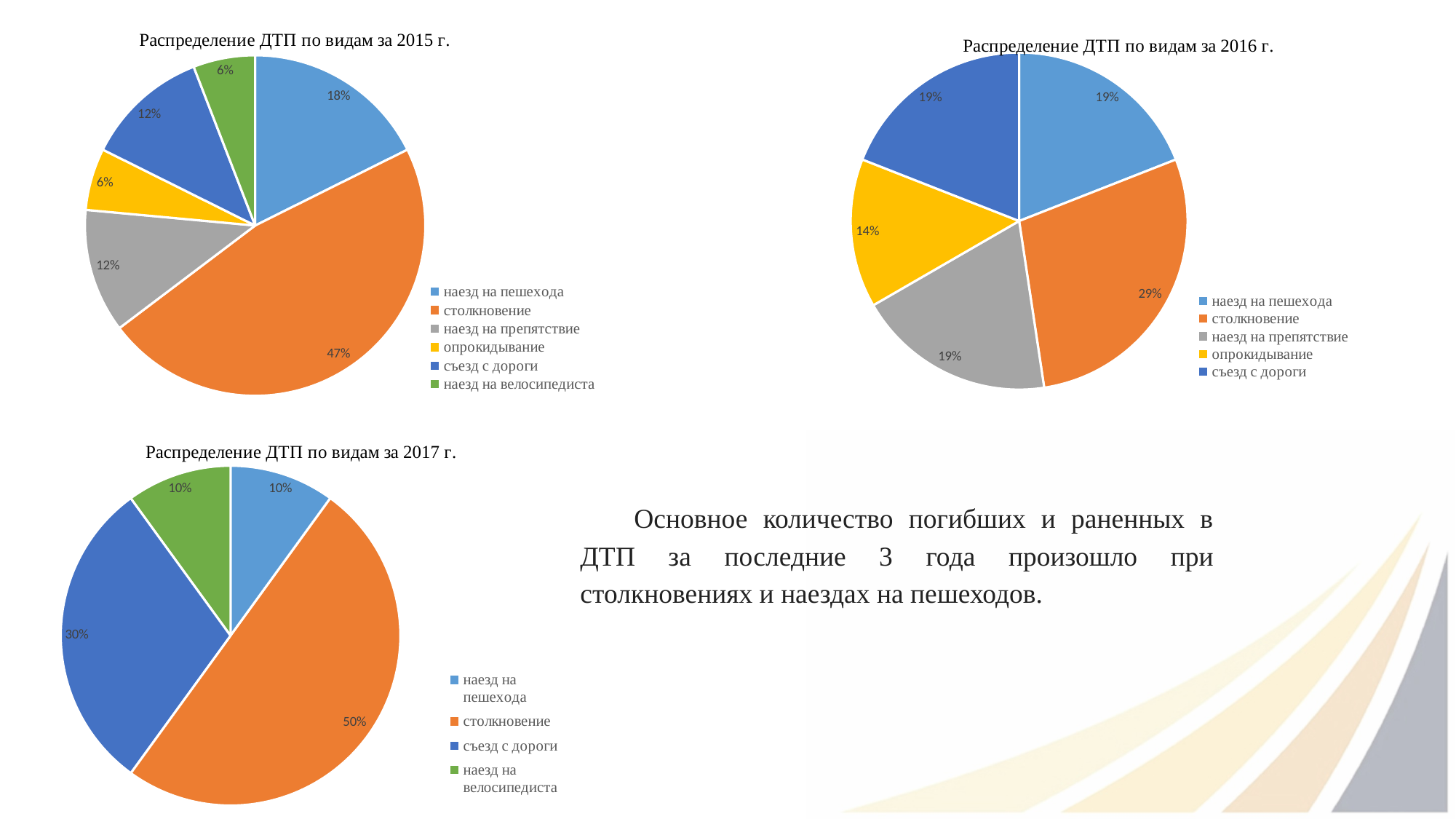
In the chart 'Распределение ДТП по видам за 2015 г.', which category has the largest share? столкновение In the chart 'Распределение ДТП по видам за 2015 г.', how many categories does the legend list? 6 In the chart 'Распределение ДТП по видам за 2015 г.', what share does 'столкновение' have? 47% In the chart 'Распределение ДТП по видам за 2015 г.', what is the share for 'наезд на пешехода'? 18% In the chart 'Распределение ДТП по видам за 2016 г.', what share does 'опрокидывание' have? 14% In the chart 'Распределение ДТП по видам за 2017 г.', which is larger: 'столкновение' or 'съезд с дороги'? столкновение In the chart 'Распределение ДТП по видам за 2016 г.', which category has the largest share? столкновение In the chart 'Распределение ДТП по видам за 2015 г.', what is the difference between the shares of 'столкновение' and 'наезд на пешехода'? 29% In the chart 'Распределение ДТП по видам за 2017 г.', what share does 'съезд с дороги' have? 30% What type of chart is 'Распределение ДТП по видам за 2017 г.'? pie chart In the chart 'Распределение ДТП по видам за 2016 г.', what is the difference between the shares of 'столкновение' and 'опрокидывание'? 15% In the chart 'Распределение ДТП по видам за 2017 г.', how many categories does the legend list? 4